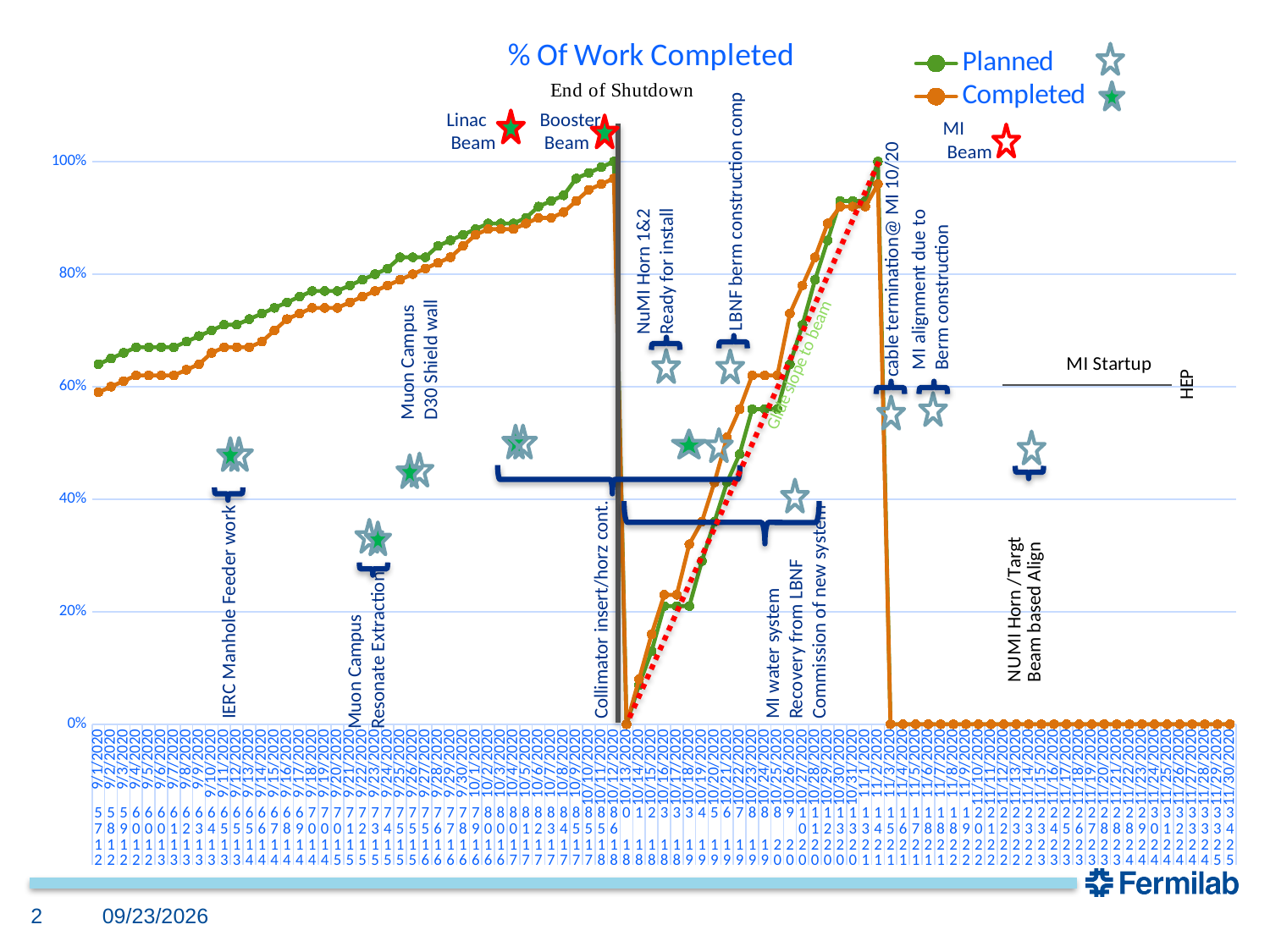
On 9/1/2020, which series has the higher value, Planned or Completed? Planned Is the Completed value on 9/20/2020 greater or less than 80%? less How many series does the legend list? 2 What is the highest tick shown on the y axis? 100% What is the title of the chart? % Of Work Completed Is the Completed value on 9/1/2020 greater or less than 80%? less What kind of chart is shown on the slide? line chart What are the two series named in the legend? Planned and Completed What is the Completed value on 11/30/2020? 0% Is the Planned value on 9/1/2020 greater or less than 60%? greater From 9/1/2020 to 10/12/2020, does the Planned series rise or fall? rise